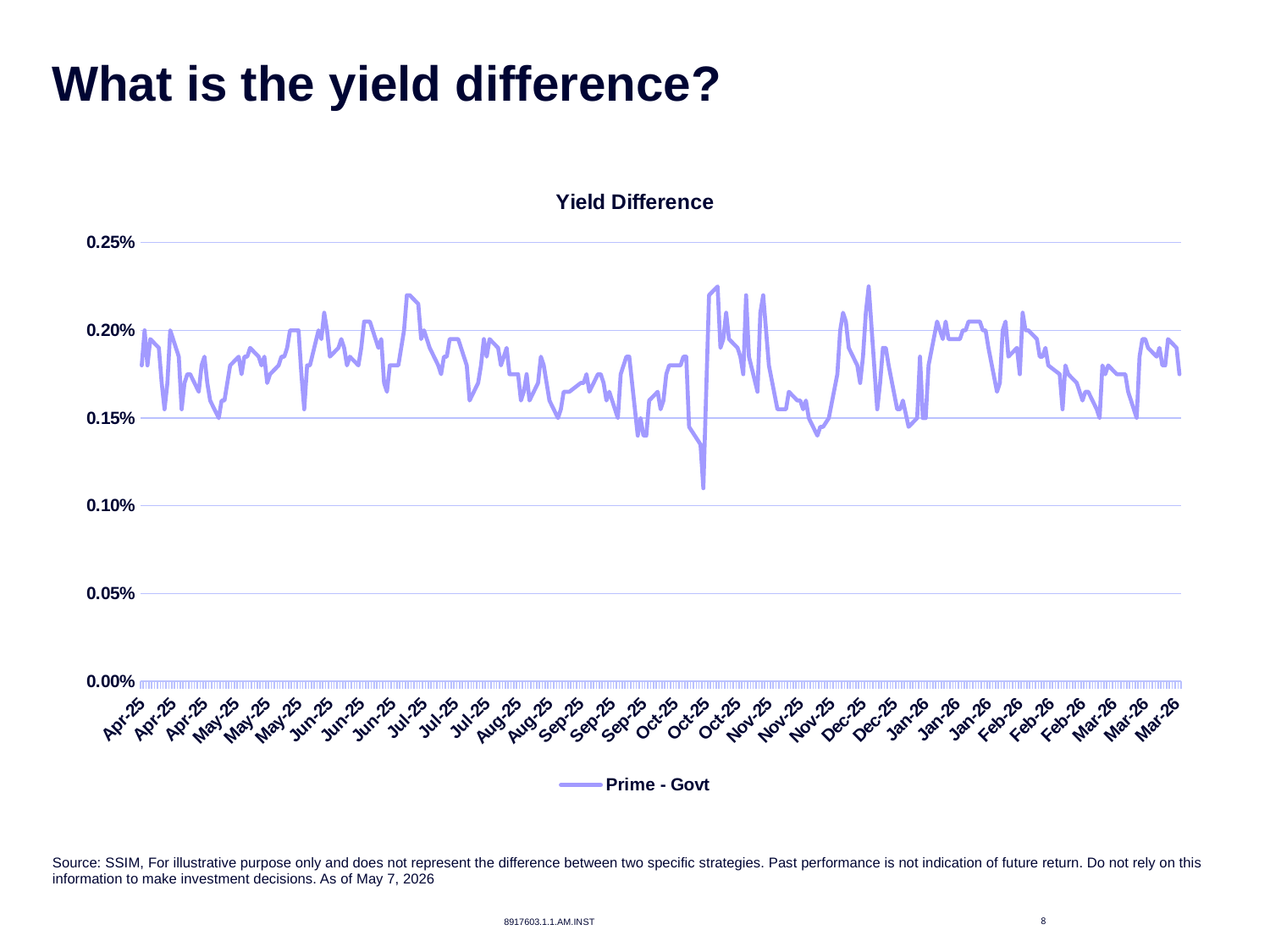
Is the highest value of the Prime - Govt line greater or less than 0.20%? greater Is the value of the Prime - Govt line at the start of the series (Apr-25) greater or less than 0.15%? greater Is the highest value of the Prime - Govt line greater or less than 0.25%? less In which month does the Prime - Govt line reach its lowest point? Oct-25 What is the title of the chart on the slide? Yield Difference How many series does the legend of the Yield Difference chart list? 1 What is the name of the series shown in the legend of the chart? Prime - Govt What kind of chart is shown on the slide? Line chart